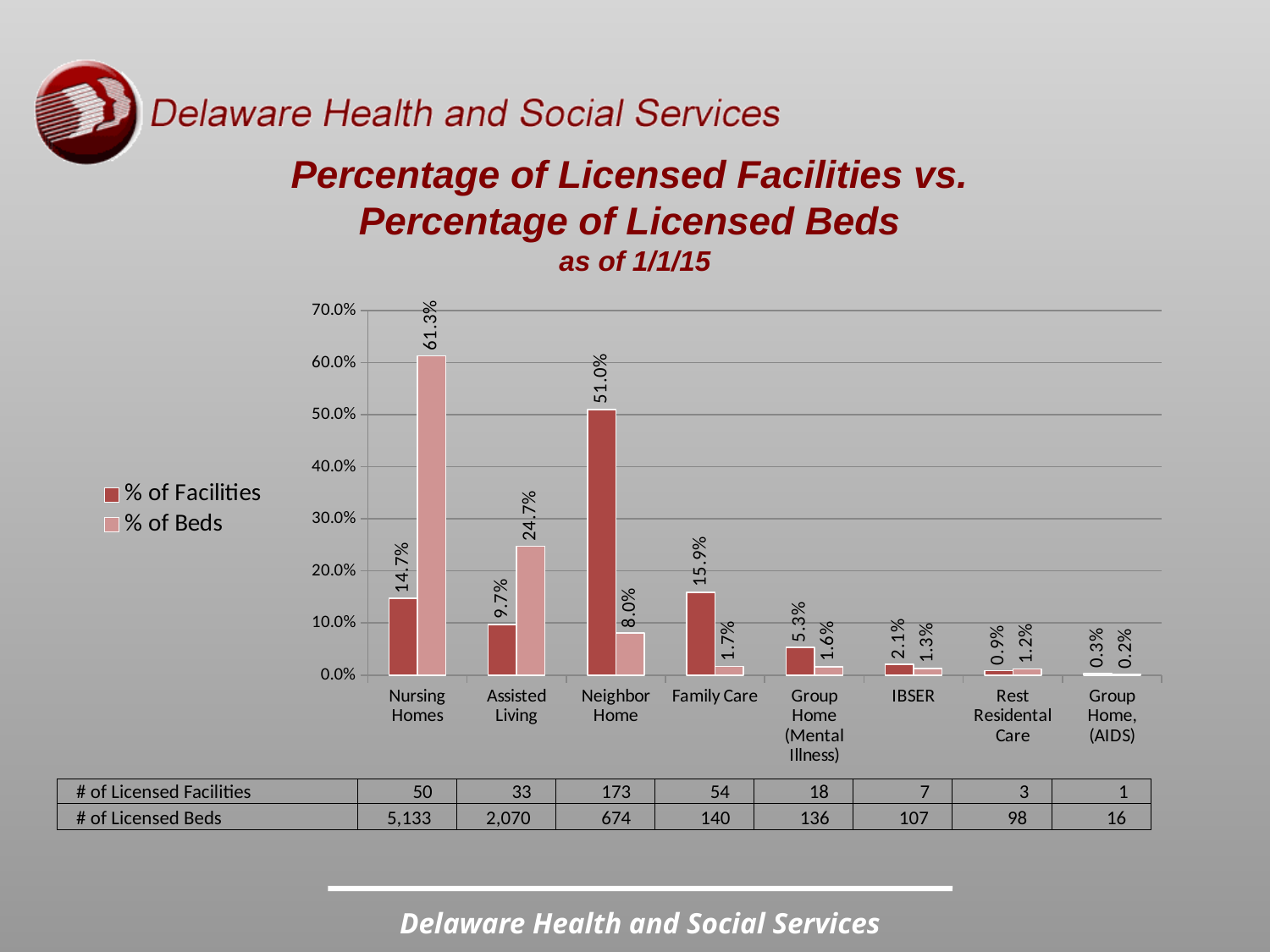
Which category has the highest % of Facilities? Neighbor Home What is the % of Facilities value for Neighbor Home? 51.0% Is the % of Beds value for Assisted Living greater or less than 20.0%? greater What is the % of Beds value for Nursing Homes? 61.3% How many categories are shown on the x axis of the chart? 8 Which category has the lowest % of Beds? Group Home, (AIDS) What kind of chart is shown on the slide? Bar chart Which is larger for Assisted Living: % of Facilities or % of Beds? % of Beds What is the % of Facilities value for Family Care? 15.9% How many series does the legend list? 2 According to the table below the chart, how many licensed beds are there for Nursing Homes? 5,133 What is the difference between the % of Beds and the % of Facilities for Nursing Homes? 46.6%